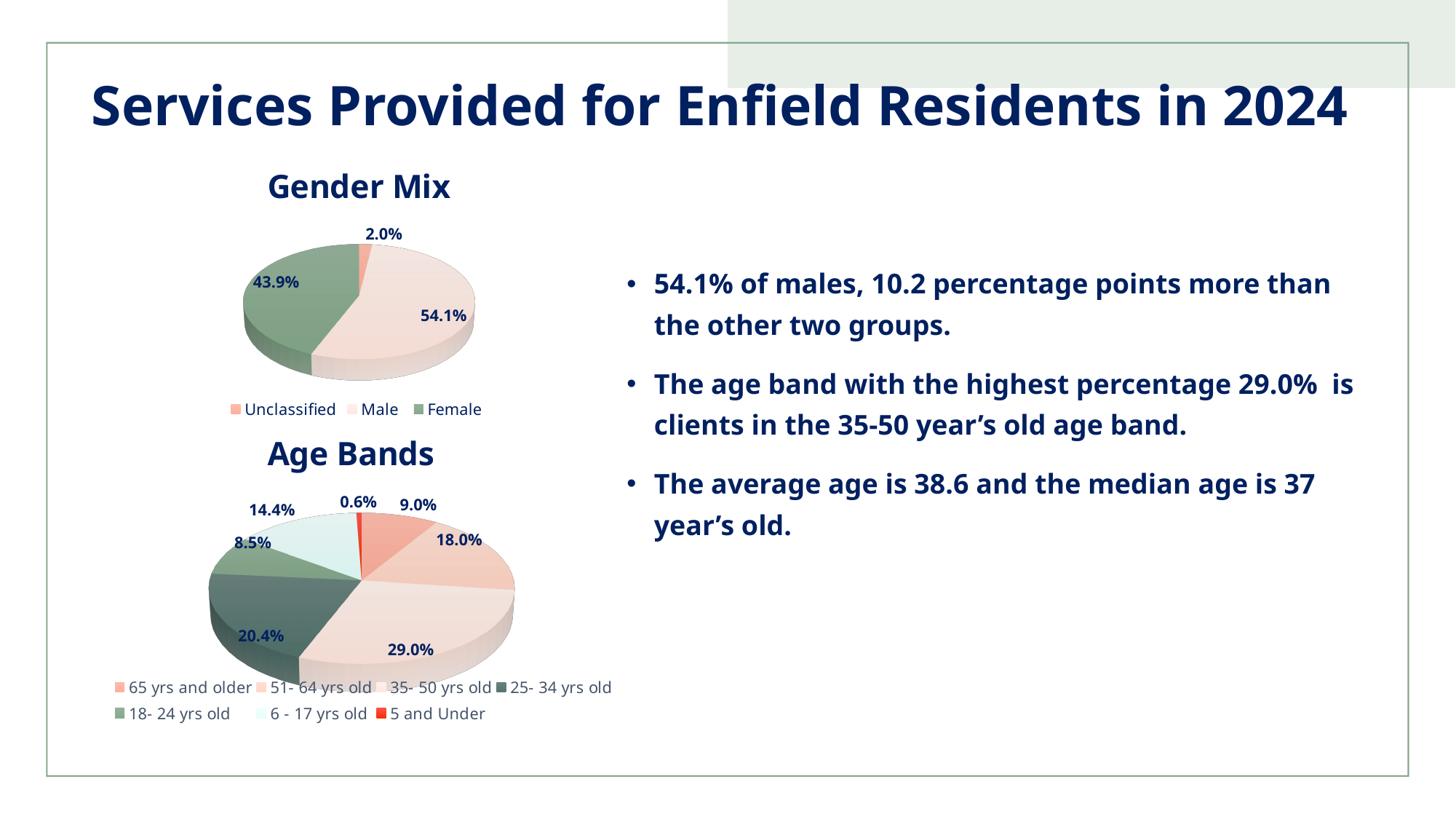
In the Gender Mix chart, what percentage is Male? 54.1% In the Age Bands chart, what percentage is the 25- 34 yrs old band? 20.4% In the Age Bands chart, which is larger: 51- 64 yrs old or 6 - 17 yrs old? 51- 64 yrs old In the Age Bands chart, what percentage is the 5 and Under band? 0.6% What type of chart is the Gender Mix chart? Pie chart How many age bands are shown in the Age Bands chart? 7 In the Age Bands chart, which age band has the smallest share? 5 and Under In the Gender Mix chart, what percentage is Female? 43.9% In the Age Bands chart, what percentage is the 35- 50 yrs old band? 29.0% In the Gender Mix chart, which category has the largest share? Male In the Gender Mix chart, what percentage is Unclassified? 2.0% In the Gender Mix chart, what is the difference in percentage points between Male and Female? 10.2